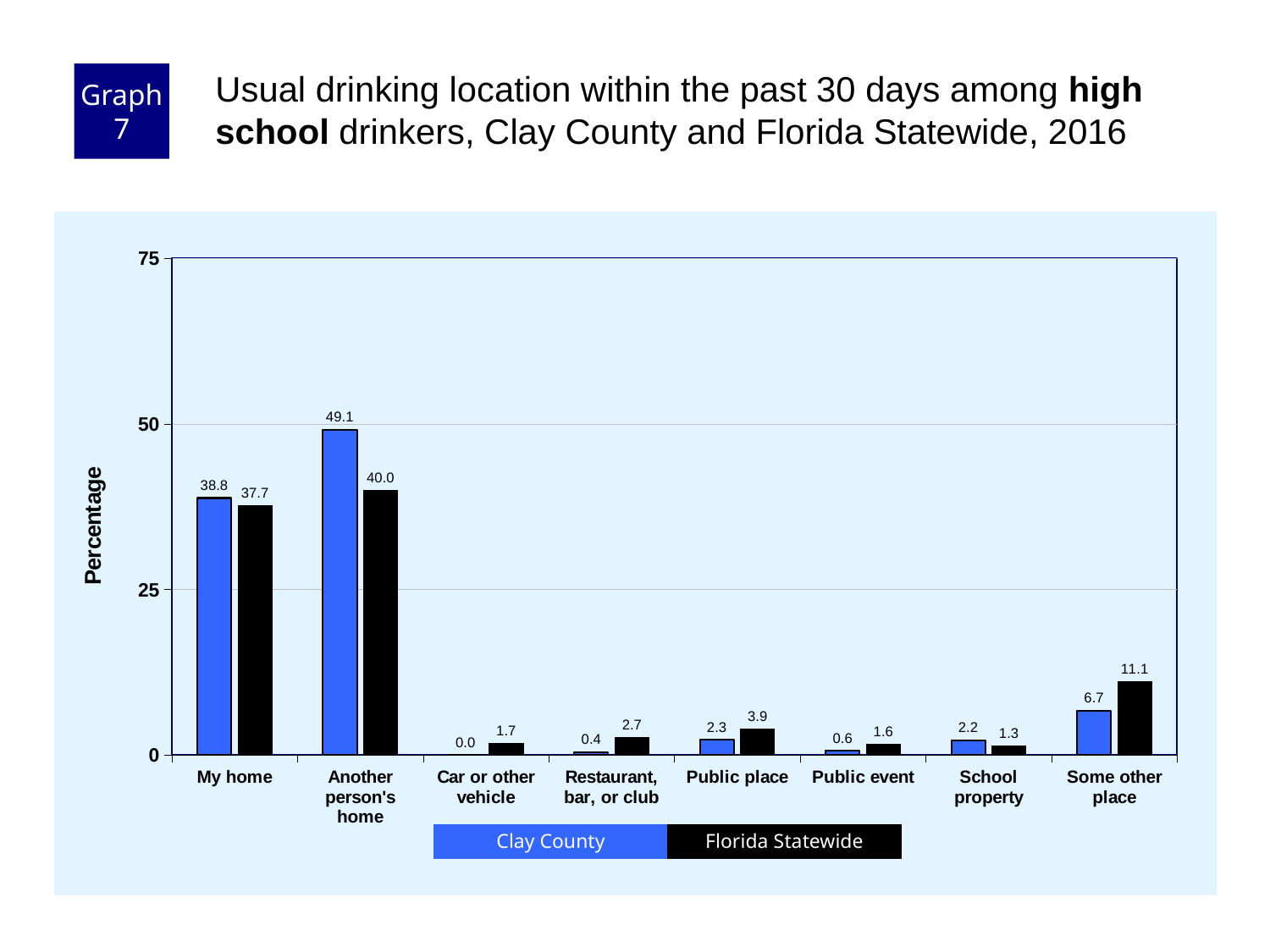
What kind of chart is shown on the slide? Bar chart Which category has the highest Clay County value? Another person's home What is the difference between the Clay County and Florida Statewide values for "Another person's home"? 9.1 How many series does the legend list? 2 What is the Florida Statewide value for "Some other place"? 11.1 Is the Florida Statewide value for "My home" greater or less than 25? greater What is the Clay County value for "Another person's home"? 49.1 What is the label of the y axis? Percentage Which category has the lowest Florida Statewide value? School property Which is larger for "Public place": Clay County or Florida Statewide? Florida Statewide How many categories are shown on the x axis? 8 What is the Clay County value for "Car or other vehicle"? 0.0